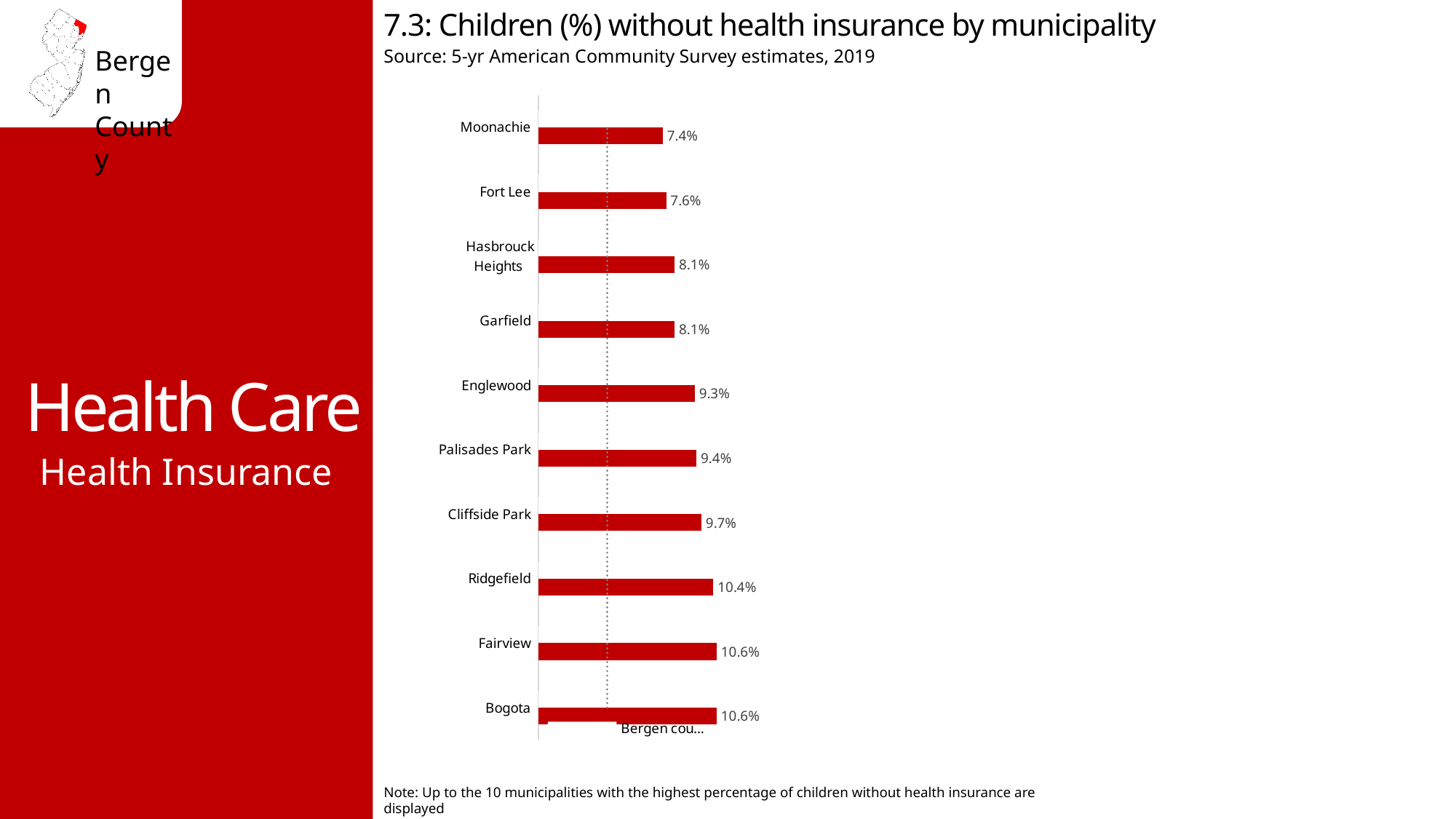
What is the difference between the values for Bogota and Moonachie? 3.2 percentage points Which municipality has the lowest percentage of children without health insurance? Moonachie What percentage is shown for Englewood? 9.3% How many municipalities are shown in the chart? 10 What is the difference between the values for Ridgefield and Englewood? 1.1 percentage points Which has a higher value, Fort Lee or Garfield? Garfield What is the value for Hasbrouck Heights? 8.1% What percentage of children in Moonachie are without health insurance? 7.4% What kind of chart is used on this slide? Bar chart Which has a higher percentage of children without health insurance, Cliffside Park or Palisades Park? Cliffside Park What is the value shown for Ridgefield? 10.4% What is the source of the data shown in the chart? 5-yr American Community Survey estimates, 2019